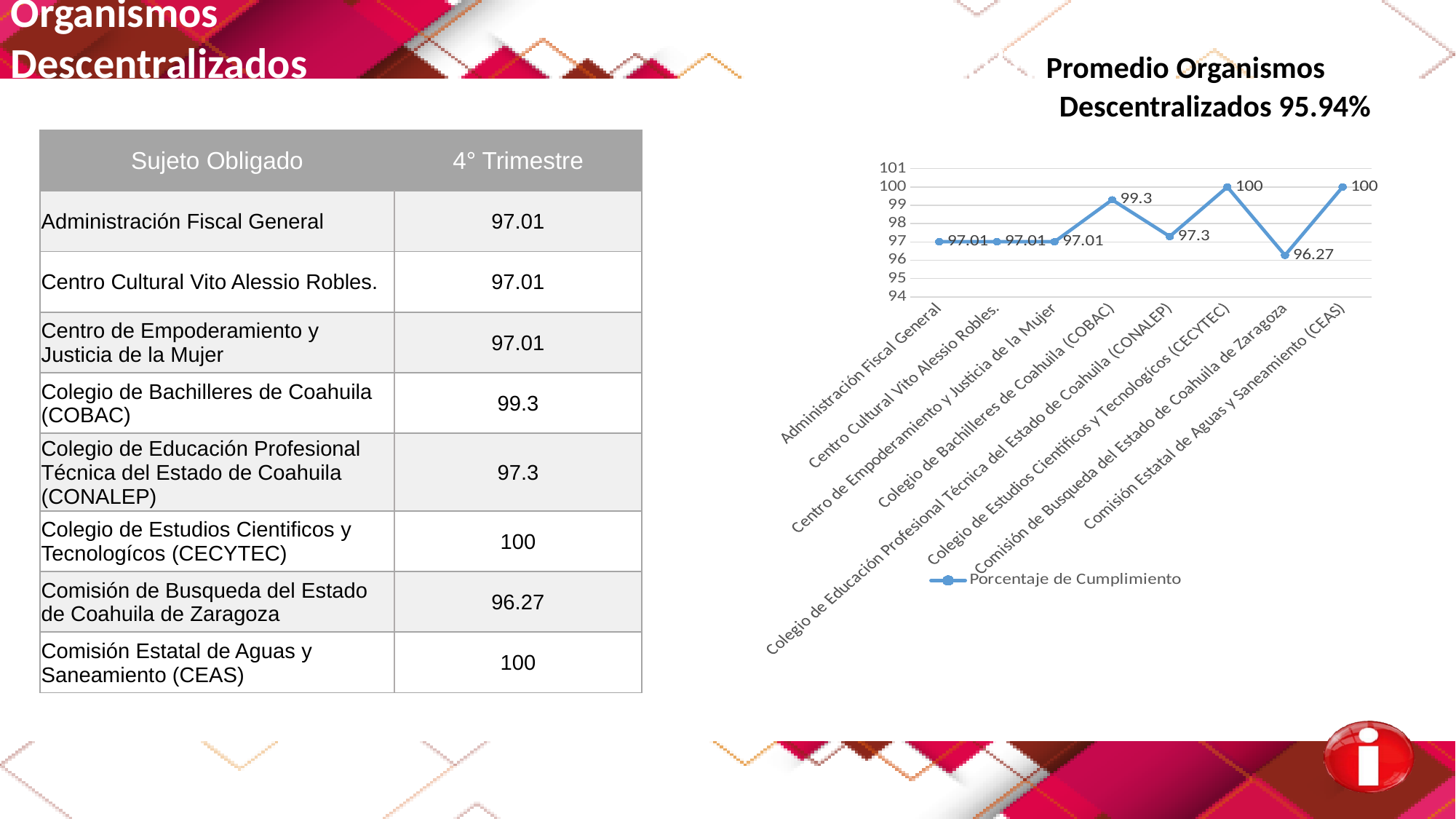
What is the value for Colegio de Educación Profesional Técnica del Estado de Coahuila (CONALEP) in the chart? 97.3 What is the value for Administración Fiscal General in the chart? 97.01 How many series does the chart's legend list? 1 Which category has the lowest value in the chart? Comisión de Busqueda del Estado de Coahuila de Zaragoza Is the value for Colegio de Bachilleres de Coahuila (COBAC) greater or less than 98? greater What kind of chart is shown on the slide? line chart What is the value for Comisión de Busqueda del Estado de Coahuila de Zaragoza in the chart? 96.27 What is the difference between the values for Colegio de Bachilleres de Coahuila (COBAC) and Comisión de Busqueda del Estado de Coahuila de Zaragoza? 3.03 How many categories are plotted on the x axis of the chart? 8 Which is larger, the value for Colegio de Bachilleres de Coahuila (COBAC) or the value for Colegio de Educación Profesional Técnica del Estado de Coahuila (CONALEP)? Colegio de Bachilleres de Coahuila (COBAC) What is the value for Colegio de Bachilleres de Coahuila (COBAC) in the chart? 99.3 What is the difference between the values for Comisión Estatal de Aguas y Saneamiento (CEAS) and Colegio de Educación Profesional Técnica del Estado de Coahuila (CONALEP)? 2.7